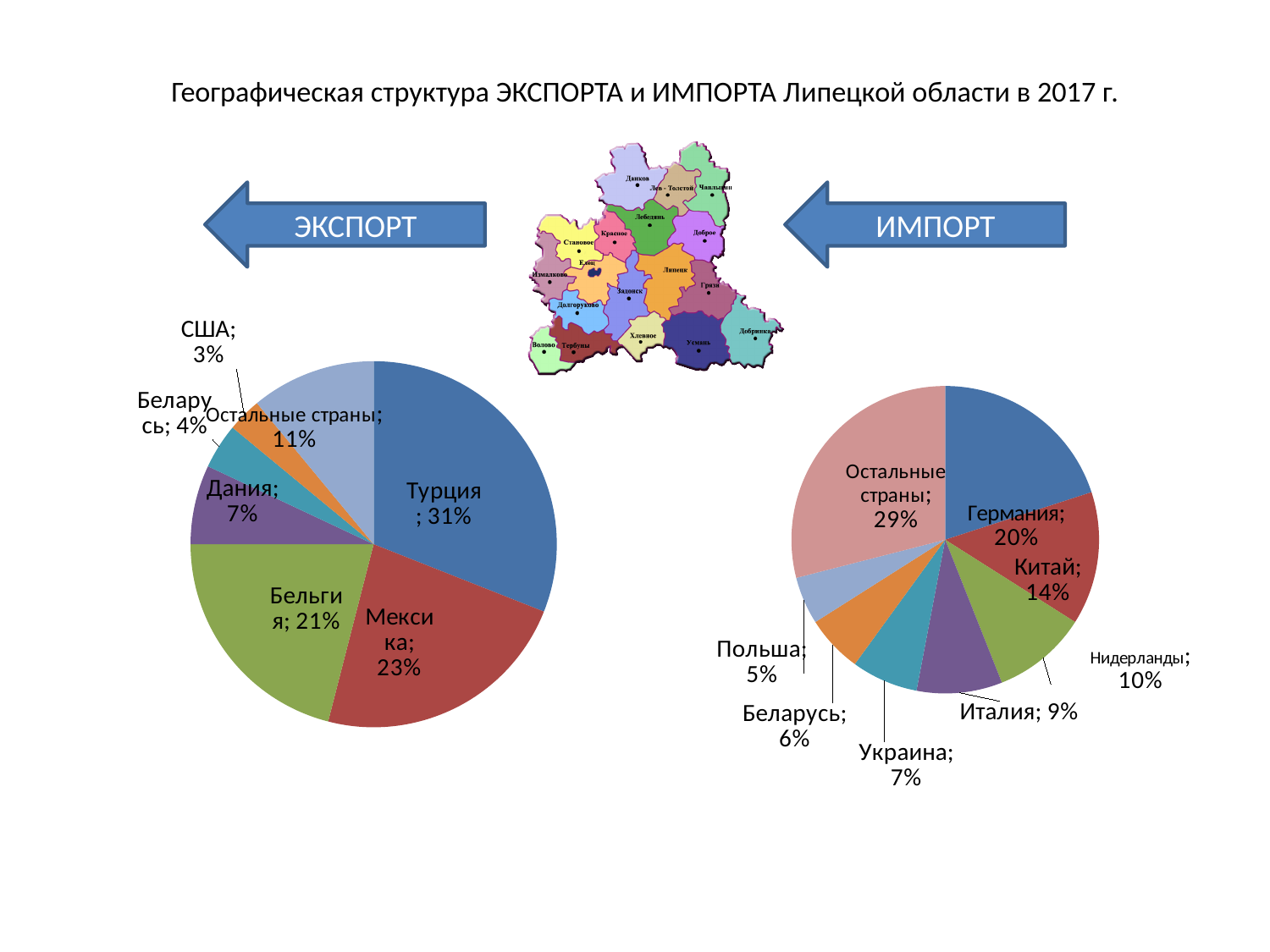
What type of chart is used for the ЭКСПОРТ and ИМПОРТ data on this slide? Pie chart In the ИМПОРТ pie chart on the right, what share does Украина have? 7% In the ИМПОРТ pie chart on the right, which is larger: the share of Китай or the share of Нидерланды? Китай In the ЭКСПОРТ pie chart on the left, which country has the smallest share? США In the ЭКСПОРТ pie chart on the left, what share does Бельгия have? 21% In the ИМПОРТ pie chart on the right, which named country (excluding Остальные страны) has the largest share? Германия How many slices does the ЭКСПОРТ pie chart on the left have? 7 In the ЭКСПОРТ pie chart on the left, what share does Турция have? 31% In the ЭКСПОРТ pie chart on the left, what is the difference between the shares of Мексика and Дания? 16% In the ЭКСПОРТ pie chart on the left, which slice is the largest? Турция How many slices does the ИМПОРТ pie chart on the right have? 8 In the ИМПОРТ pie chart on the right, what share does Германия have? 20%